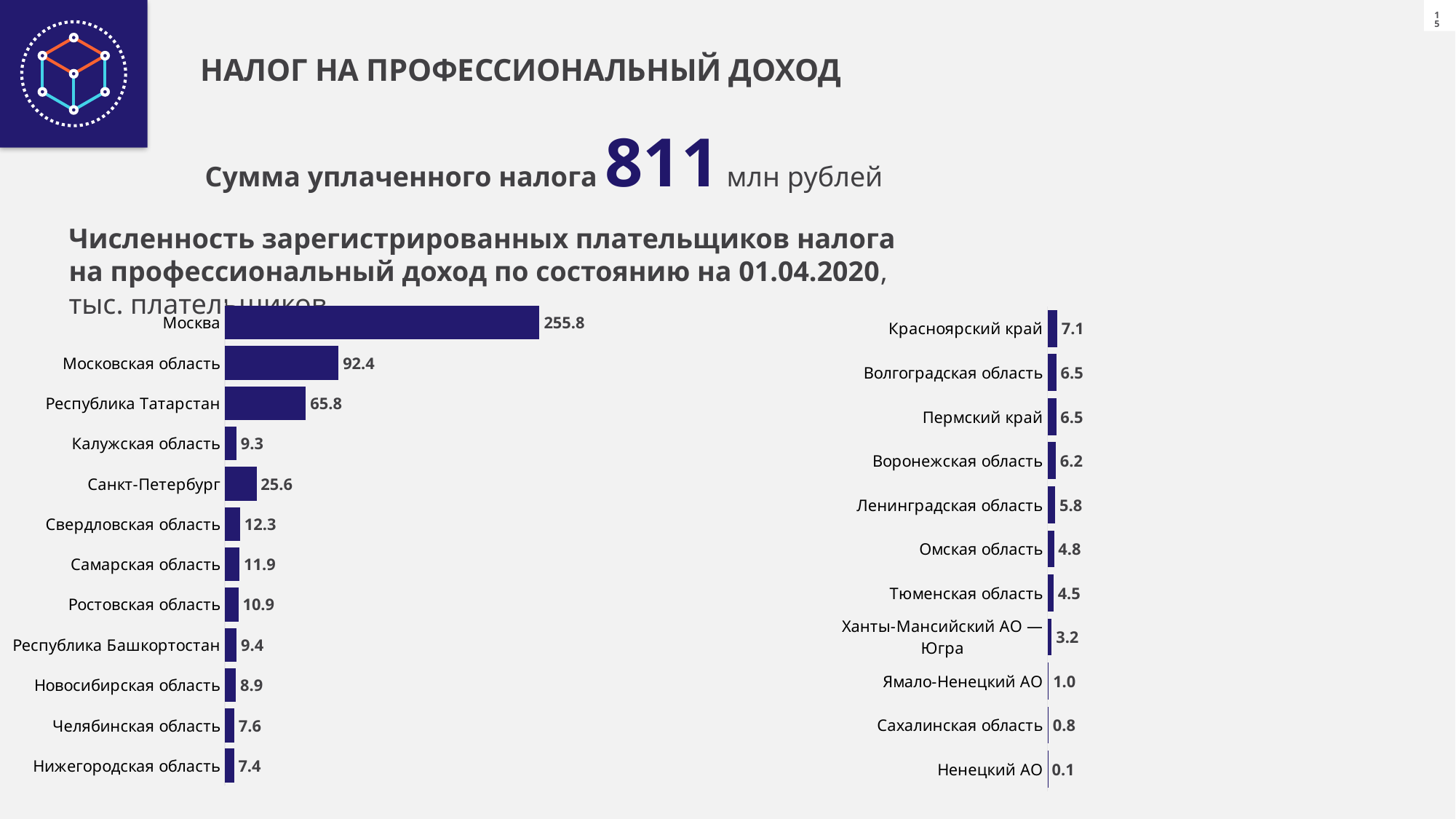
In the right chart, what is the value for Омская область? 4.8 In the right chart, which category has the lowest value? Ненецкий АО In the right chart, which category has the highest value? Красноярский край In the right chart, what is the difference between the values for Красноярский край and Ленинградская область? 1.3 How many categories are shown in the left chart? 12 How many categories are shown in the right chart? 11 In the left chart, which is larger: the value for Республика Татарстан or the value for Санкт-Петербург? Республика Татарстан In the left chart, what is the value for Санкт-Петербург? 25.6 In the left chart, what is the difference between the values for Москва and Московская область? 163.4 In the left chart, which category has the highest value? Москва What type of chart is the left chart? Bar chart In the left chart, what is the value for Москва? 255.8